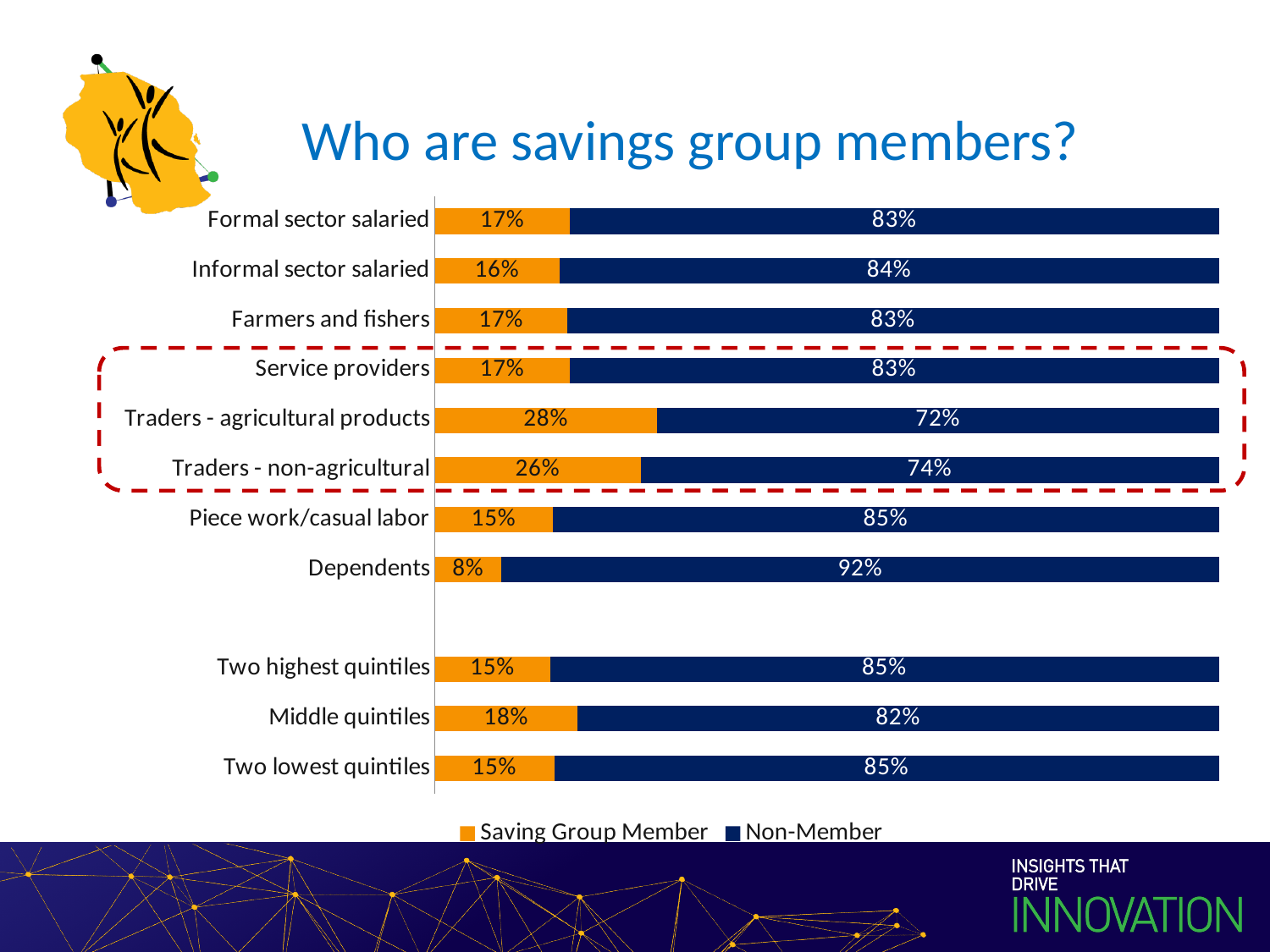
Which has a larger Saving Group Member share, Informal sector salaried or Middle quintiles? Middle quintiles What is the Non-Member value for Dependents? 92% What percentage of Traders - agricultural products are Saving Group Members? 28% What is the total of the Saving Group Member and Non-Member values for Piece work/casual labor? 100% What type of chart is shown on the slide? Stacked bar chart Which colour represents Non-Member in the chart? Dark blue What is the Saving Group Member value for Middle quintiles? 18% How many series does the legend list? 2 Which category has the highest Saving Group Member share? Traders - agricultural products What is the difference in Saving Group Member share between Traders - agricultural products and Traders - non-agricultural? 2% Which category has the lowest Saving Group Member share? Dependents What is the title of the chart? Who are savings group members?